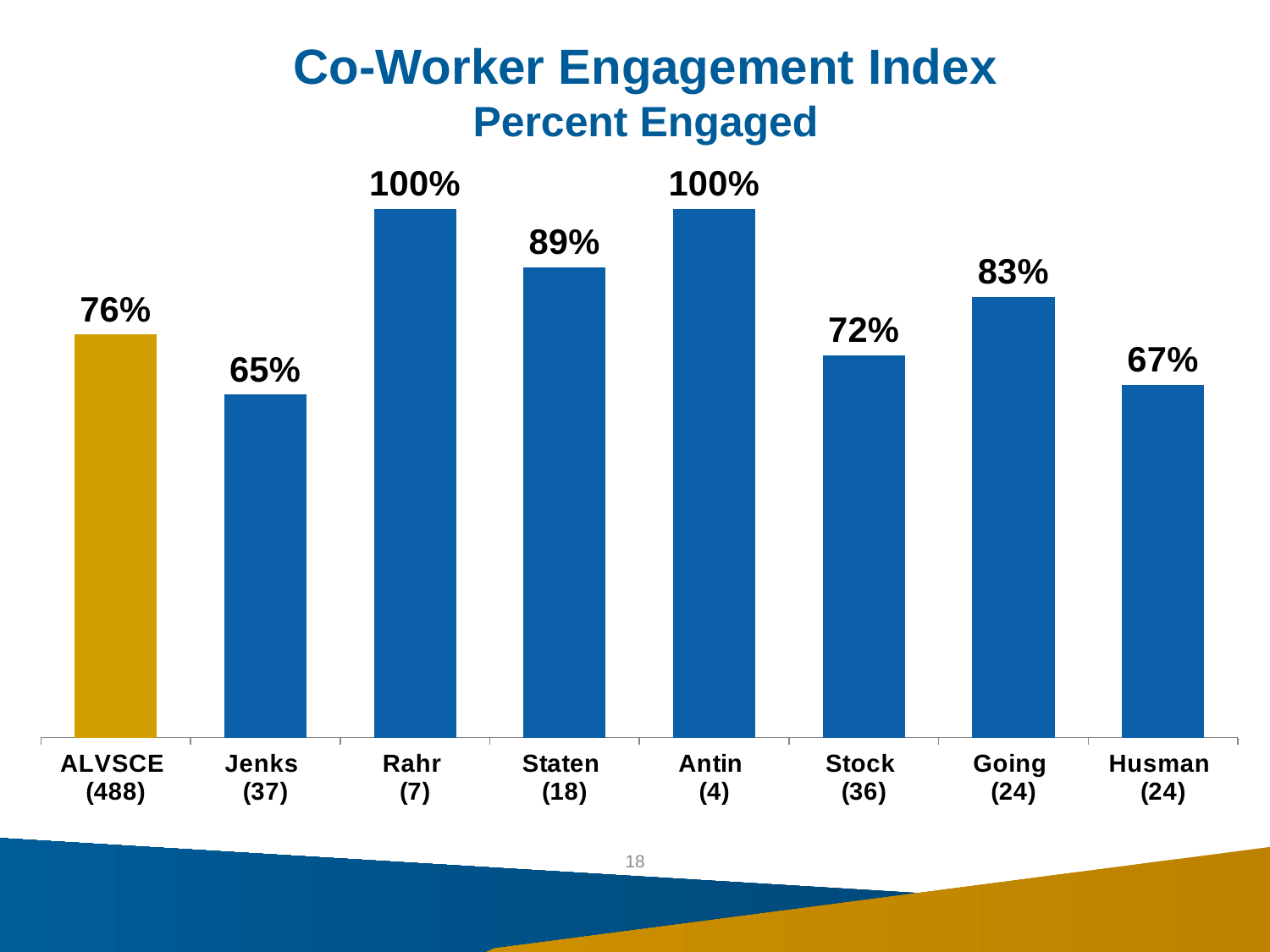
Which categories share the highest percent engaged? Rahr and Antin What is the difference in percent engaged between Rahr and Jenks? 35% What is the percent engaged for ALVSCE? 76% Which category has the lowest percent engaged? Jenks How many categories are shown on the chart? 8 What kind of chart is shown on the slide? Bar chart Which has a higher percent engaged, Jenks or Husman? Husman Which bar is shown in a different colour (gold) from the others? ALVSCE What is the percent engaged for Going? 83% What is the percent engaged for Staten? 89% Which has a higher percent engaged, Stock or Going? Going What is the difference in percent engaged between ALVSCE and Husman? 9%